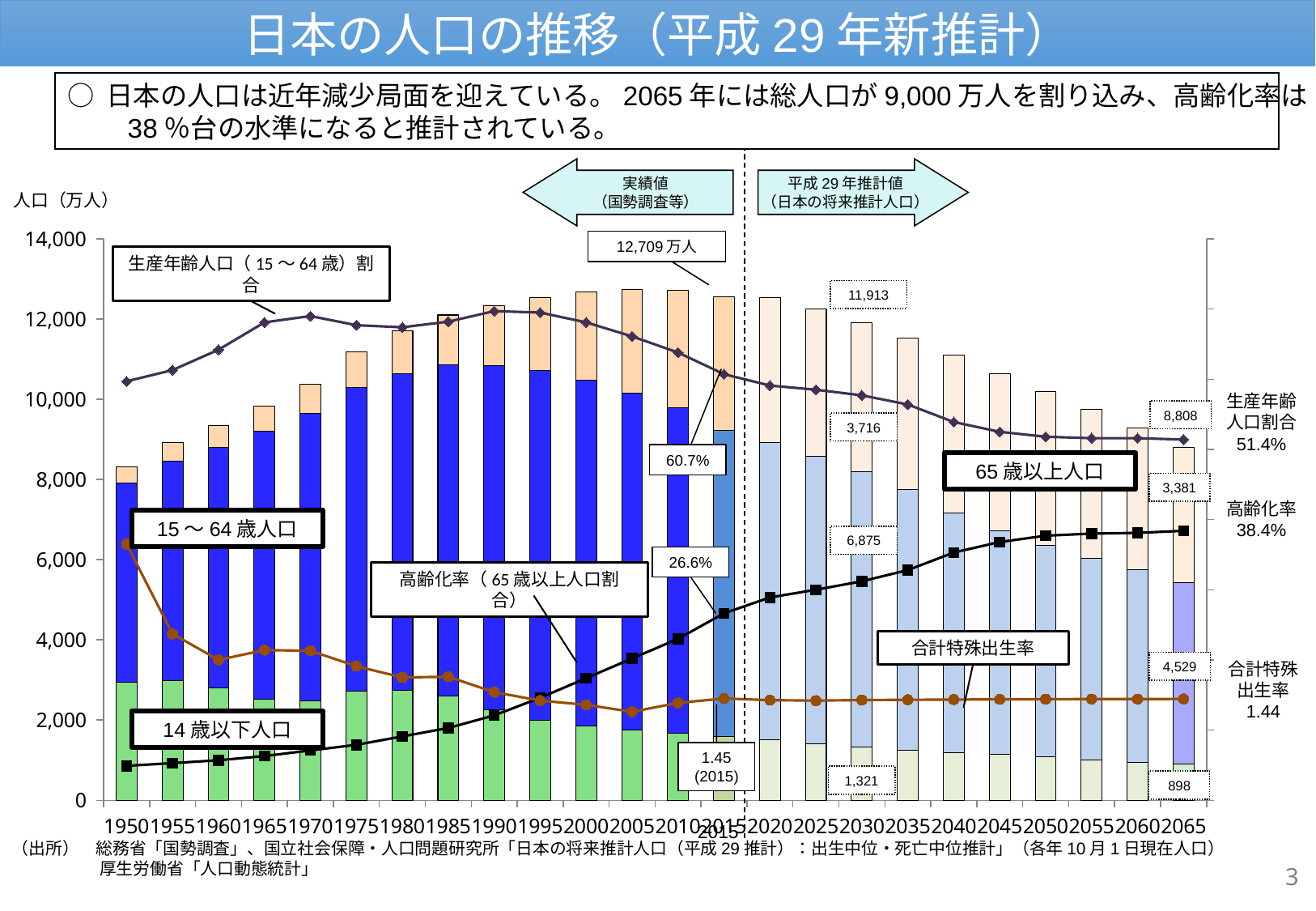
What is the 65歳以上人口 value labelled for 2030? 3,716 Which year has the larger labelled 65歳以上人口, 2030 or 2065? 2030 Does the 高齢化率 line rise or fall from 1950 to 2065? rises What is the 合計特殊出生率 shown for 2015? 1.45 Is the total population bar for 1950 greater or less than 10,000? less What is the 15～64歳人口 value labelled for 2065? 4,529 What is the 高齢化率 shown for 2065? 38.4% What is the difference between the total population labelled for 2030 (11,913) and for 2065 (8,808)? 3,105 How many years (bars) are plotted on the x axis? 24 What is the 生産年齢人口割合 shown for 2015? 60.7% What is the 14歳以下人口 value labelled for 2065? 898 What is the total population shown for 2015? 12,709万人